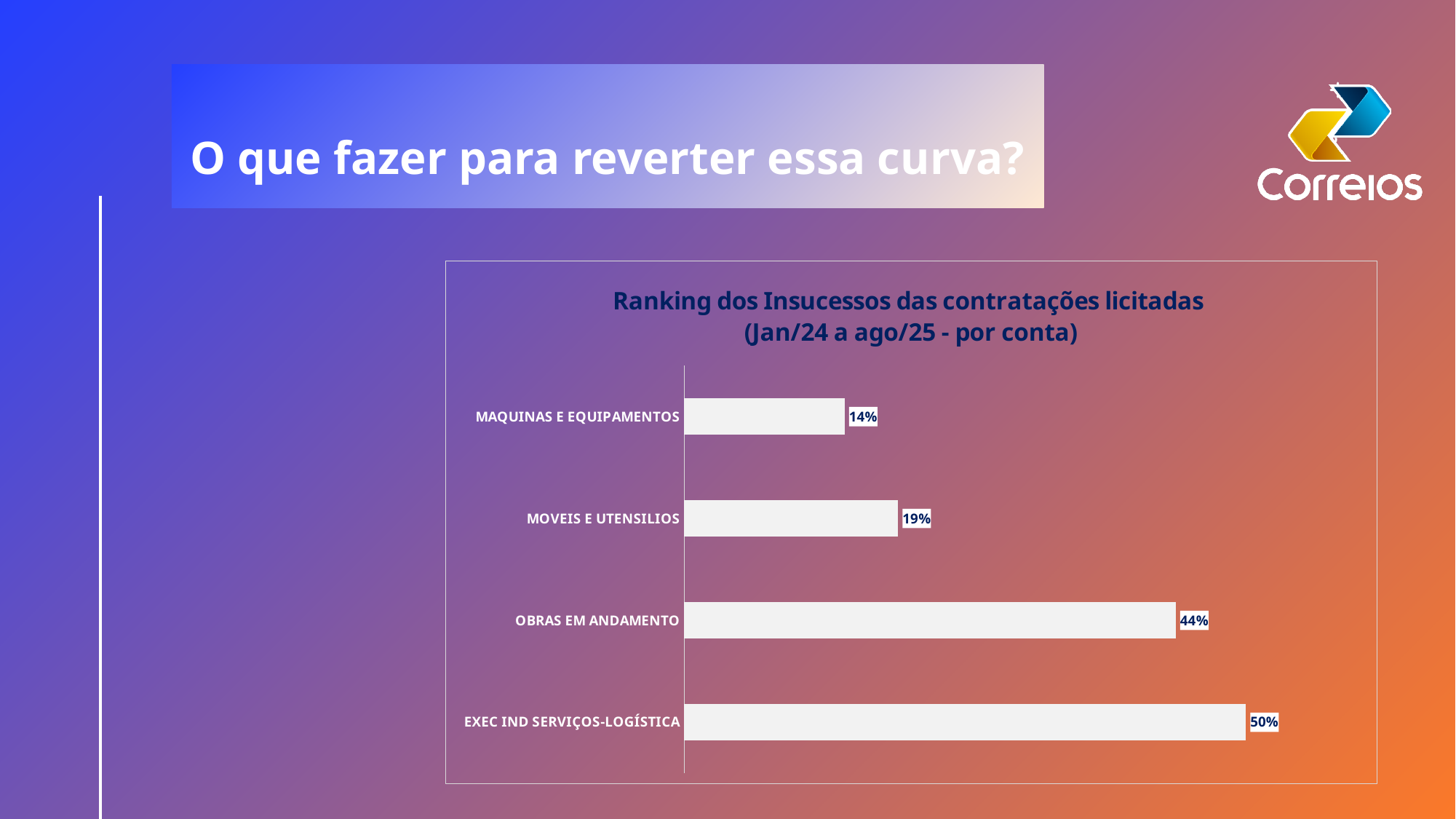
What is the value for MOVEIS E UTENSILIOS? 19% What kind of chart is shown on the slide? Bar chart Which is larger, the value for OBRAS EM ANDAMENTO or the value for MOVEIS E UTENSILIOS? OBRAS EM ANDAMENTO What is the difference between the values for MOVEIS E UTENSILIOS and MAQUINAS E EQUIPAMENTOS? 5% Which category has the highest value? EXEC IND SERVIÇOS-LOGÍSTICA What is the value for OBRAS EM ANDAMENTO? 44% What is the title of the chart? Ranking dos Insucessos das contratações licitadas (Jan/24 a ago/25 - por conta) What is the value for MAQUINAS E EQUIPAMENTOS? 14% What is the value for EXEC IND SERVIÇOS-LOGÍSTICA? 50% What is the difference between the values for EXEC IND SERVIÇOS-LOGÍSTICA and OBRAS EM ANDAMENTO? 6% Which category has the lowest value? MAQUINAS E EQUIPAMENTOS How many categories are shown in the chart? 4